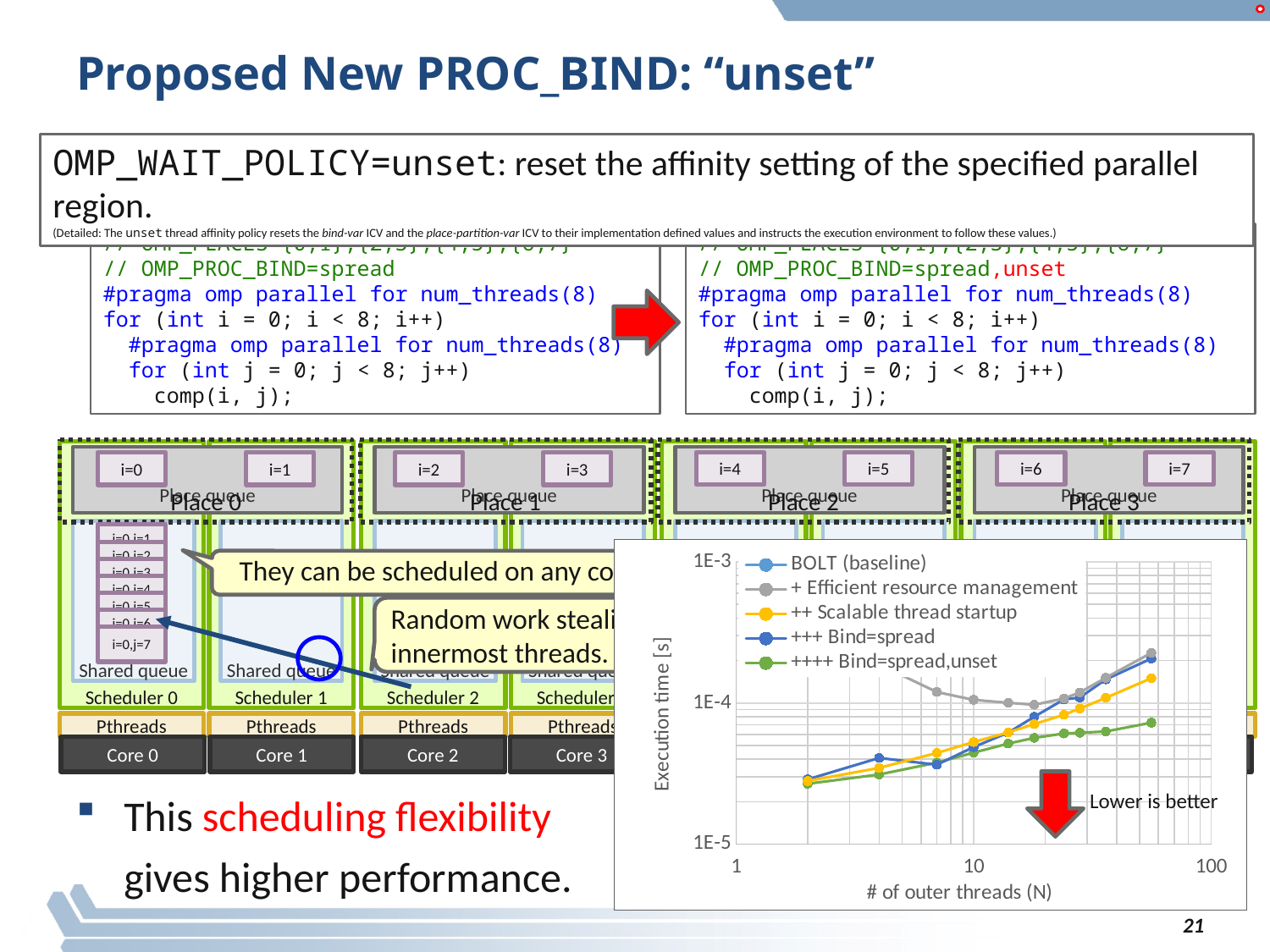
How many series does the chart's legend list? 5 What kind of chart is shown on the slide? line chart What is the label of the chart's x axis? # of outer threads (N) Does the execution time for BOLT (baseline) rise or fall as the number of outer threads increases? rise Which series in the chart has the lowest execution time at the largest number of outer threads? ++++ Bind=spread,unset Is the execution time for + Efficient resource management at the largest number of outer threads greater or less than 1E-4? greater What is the label of the chart's y axis? Execution time [s] At the largest number of outer threads, which series has the higher execution time: + Efficient resource management or ++++ Bind=spread,unset? + Efficient resource management Is the execution time for BOLT (baseline) at the smallest number of outer threads greater or less than 1E-4? less How many labeled tick values are shown on the chart's x axis? 3 Is the execution time for ++++ Bind=spread,unset at the largest number of outer threads greater or less than 1E-4? less At the largest number of outer threads, which series has the lower execution time: +++ Bind=spread or ++++ Bind=spread,unset? ++++ Bind=spread,unset